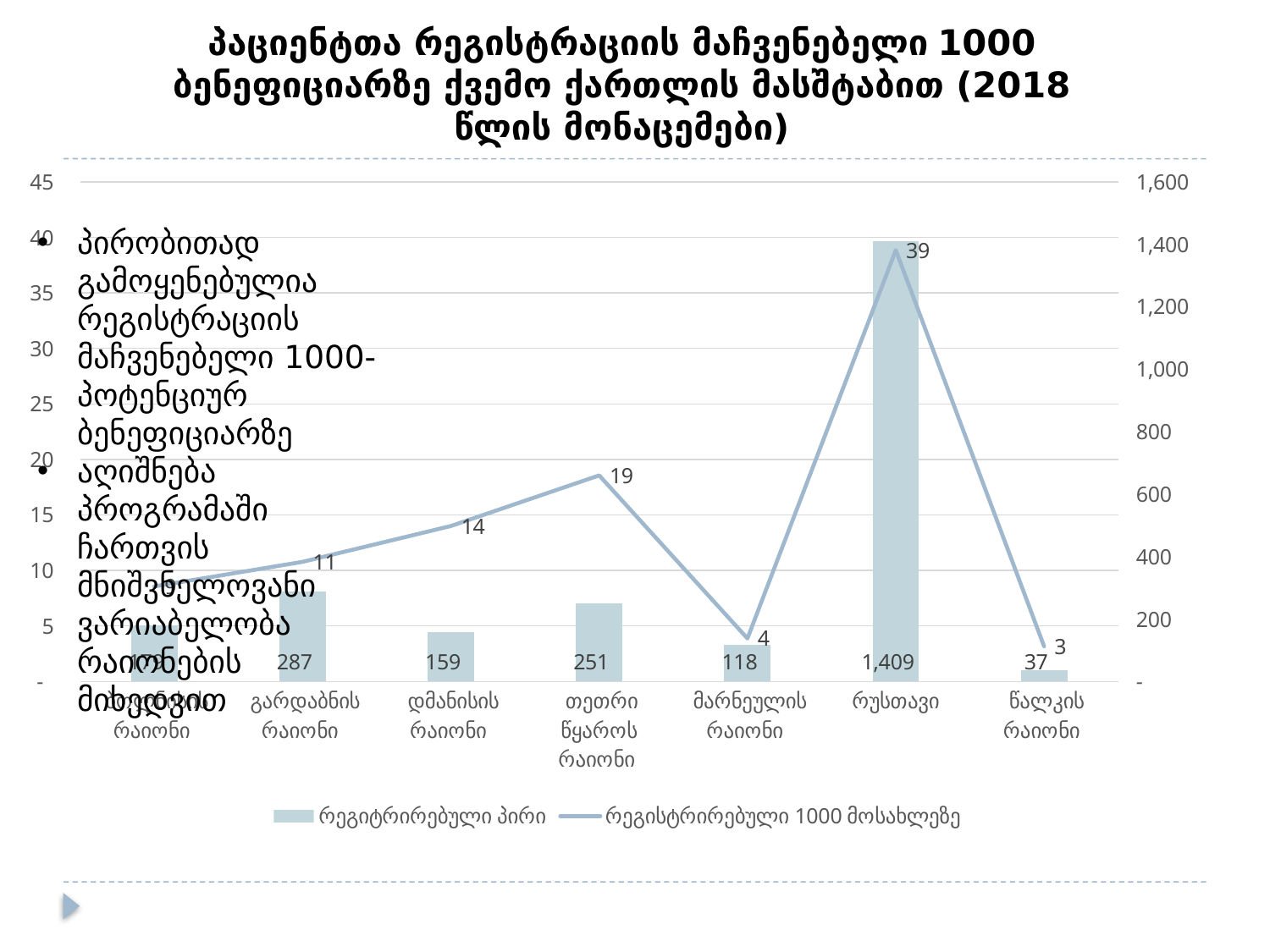
What is the difference in რეგიტრირებული პირი between გარდაბნის რაიონი and დმანისის რაიონი? 128 How many categories are shown on the x axis? 7 Which has a higher value of რეგისტრირებული 1000 მოსახლეზე, დმანისის რაიონი or მარნეულის რაიონი? დმანისის რაიონი Which category has the lowest value of რეგისტრირებული 1000 მოსახლეზე? წალკის რაიონი What is the value of რეგიტრირებული პირი for რუსთავი? 1,409 Which category has the highest value of რეგიტრირებული პირი? რუსთავი What is the value of რეგიტრირებული პირი for გარდაბნის რაიონი? 287 How many series does the legend list? 2 Which series is drawn as a line? რეგისტრირებული 1000 მოსახლეზე What is the value of რეგისტრირებული 1000 მოსახლეზე for თეთრი წყაროს რაიონი? 19 What is the value of რეგისტრირებული 1000 მოსახლეზე for წალკის რაიონი? 3 What kind of chart is shown on the slide? Combined bar and line chart